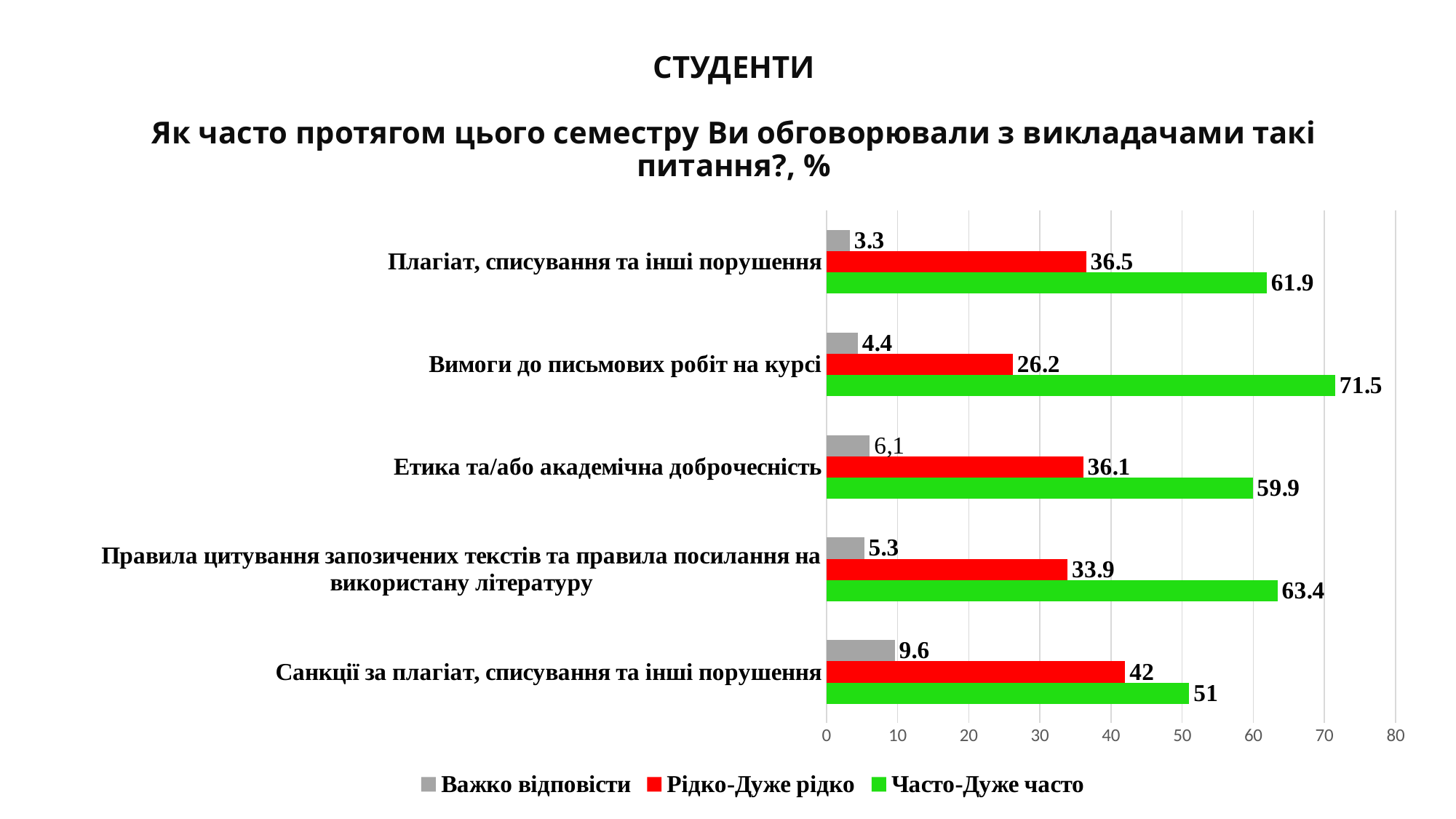
How many categories are shown on the chart? 5 What kind of chart is shown on the slide? bar chart What is the value for "Рідко-Дуже рідко" for "Санкції за плагіат, списування та інші порушення"? 42 How many series does the legend list? 3 Which is larger for "Етика та/або академічна доброчесність": the "Рідко-Дуже рідко" value or the "Часто-Дуже часто" value? Часто-Дуже часто Which colour represents the "Рідко-Дуже рідко" series? red What is the value for "Важко відповісти" for "Плагіат, списування та інші порушення"? 3.3 Is the "Часто-Дуже часто" value for "Правила цитування запозичених текстів та правила посилання на використану літературу" greater or less than 60? greater Which category has the highest value for "Часто-Дуже часто"? Вимоги до письмових робіт на курсі What is the difference between the "Часто-Дуже часто" and "Рідко-Дуже рідко" values for "Санкції за плагіат, списування та інші порушення"? 9 Which category has the lowest value for "Важко відповісти"? Плагіат, списування та інші порушення What is the value for "Часто-Дуже часто" for "Вимоги до письмових робіт на курсі"? 71.5